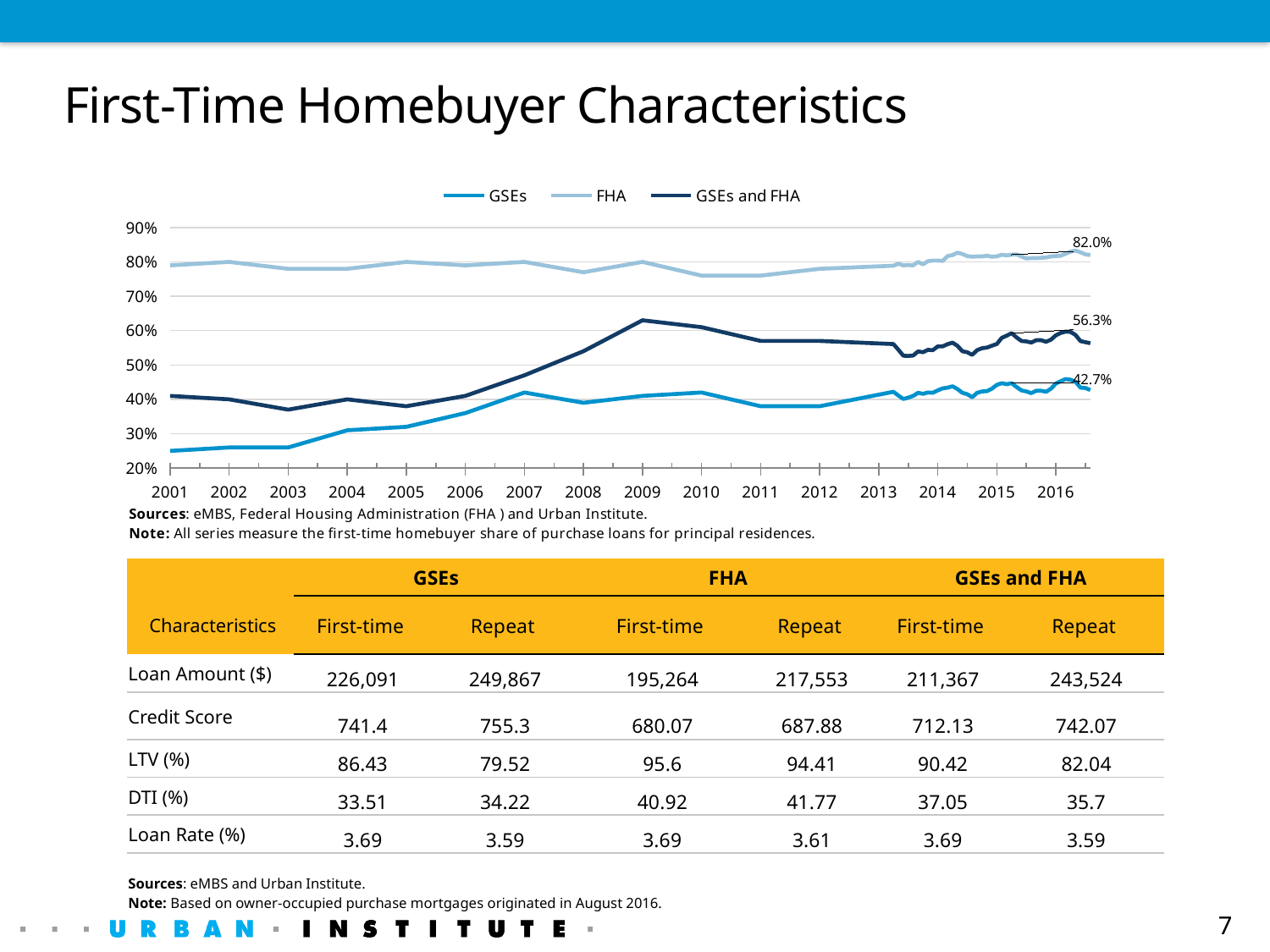
What is the labelled value at the end of the GSEs and FHA line? 56.3% Does the GSEs line rise or fall between 2001 and 2007? rise Is the value for FHA in 2010 greater or less than 70%? greater What is the labelled value at the end of the FHA line? 82.0% What kind of chart is shown on the slide? line chart How many series does the chart's legend list? 3 What is the labelled value at the end of the GSEs line? 42.7% What are the three entries in the chart's legend? GSEs, FHA, GSEs and FHA Is the value for GSEs in 2001 greater or less than 30%? less Which series has the lowest value at the end of the chart? GSEs What is the difference between the labelled end values of the FHA line and the GSEs line? 39.3 percentage points Which series has the highest value at the end of the chart? FHA